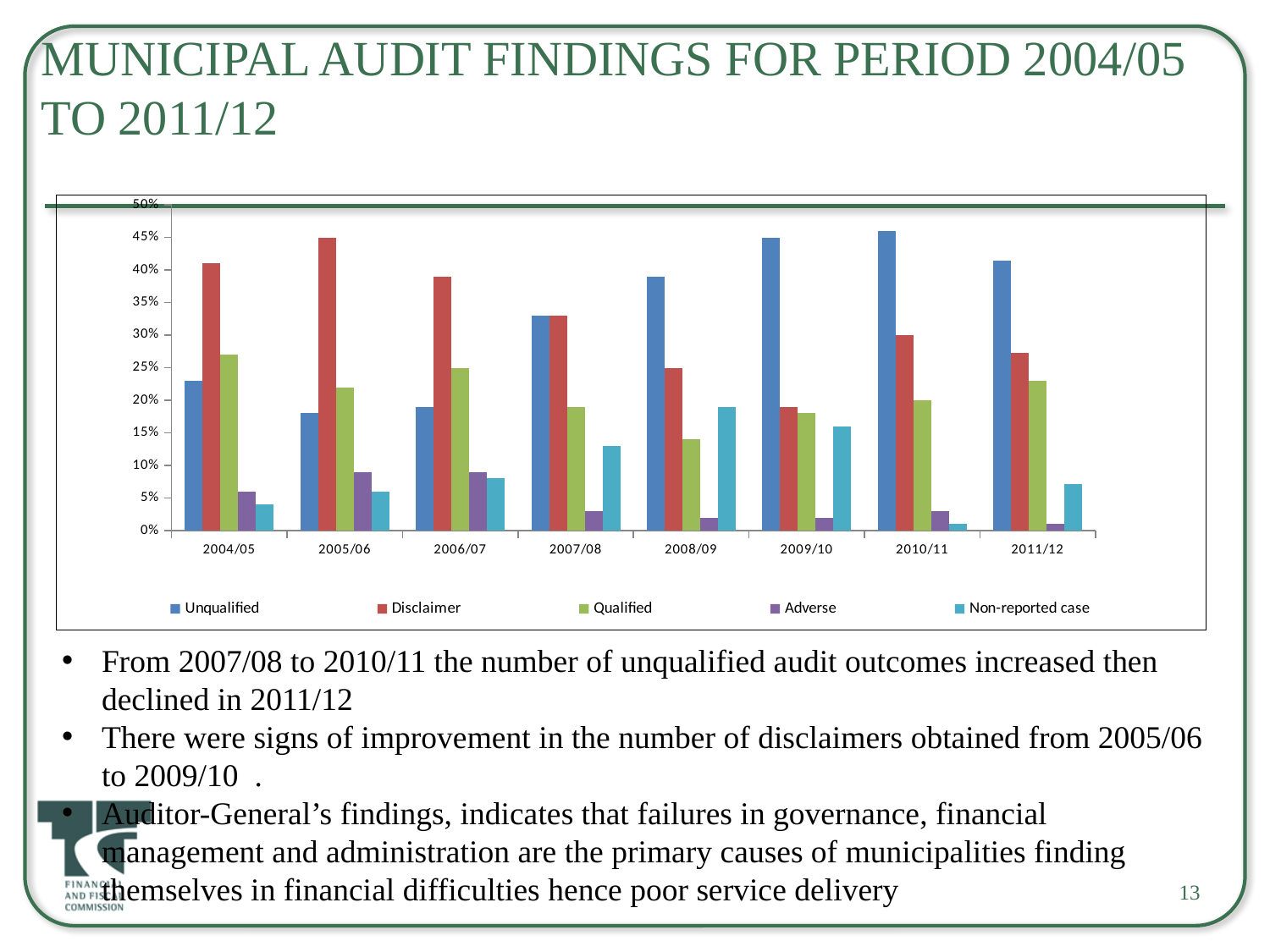
In which year is the Non-reported case bar the lowest? 2010/11 In which year is the Disclaimer bar the highest? 2005/06 Do the Unqualified values rise or fall from 2007/08 to 2010/11? rise In 2011/12, which is larger: Unqualified or Qualified? Unqualified Is the Disclaimer value for 2011/12 greater or less than 30%? less Which series has the highest bar in 2006/07? Disclaimer In 2004/05, which is larger: Unqualified or Disclaimer? Disclaimer What kind of chart is shown on the slide? bar chart Is the Adverse value for 2007/08 greater or less than 5%? less How many series does the legend list? 5 How many financial years are shown on the x axis? 8 Is the Unqualified value for 2009/10 greater or less than 40%? greater